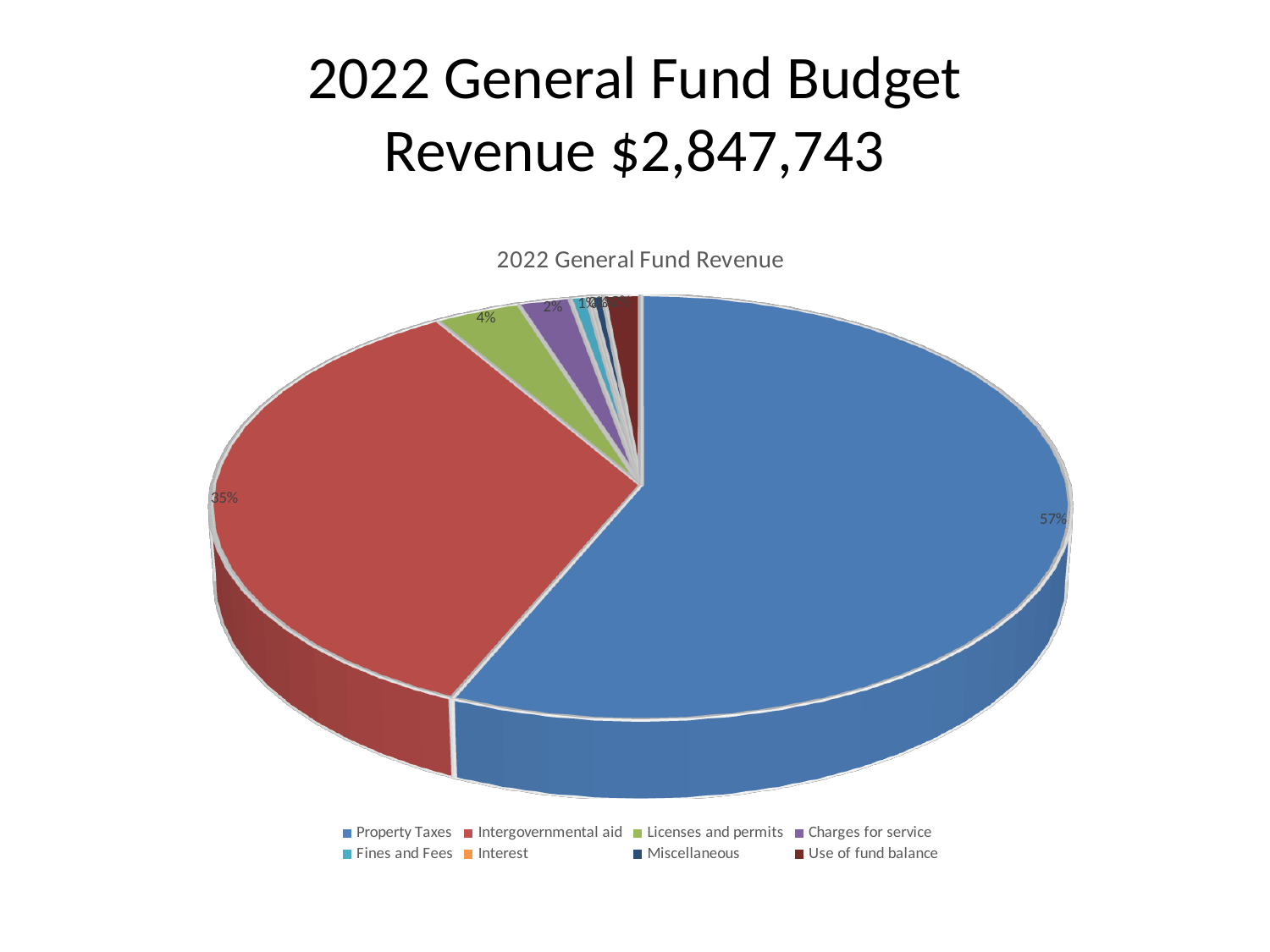
How many revenue categories does the legend list? 8 Which is larger, the Property Taxes slice or the Intergovernmental aid slice? Property Taxes What share of 2022 General Fund Revenue comes from Licenses and permits? 4% What share of 2022 General Fund Revenue comes from Charges for service? 2% What kind of chart is shown on the slide? pie chart What share of 2022 General Fund Revenue comes from Intergovernmental aid? 35% Which is larger, the Licenses and permits slice or the Charges for service slice? Licenses and permits Which revenue category has the largest slice of the pie? Property Taxes What total revenue amount is stated in the slide title? $2,847,743 What is the title of the pie chart? 2022 General Fund Revenue By how many percentage points does the Property Taxes share exceed the Intergovernmental aid share? 22 percentage points What share of 2022 General Fund Revenue comes from Property Taxes? 57%